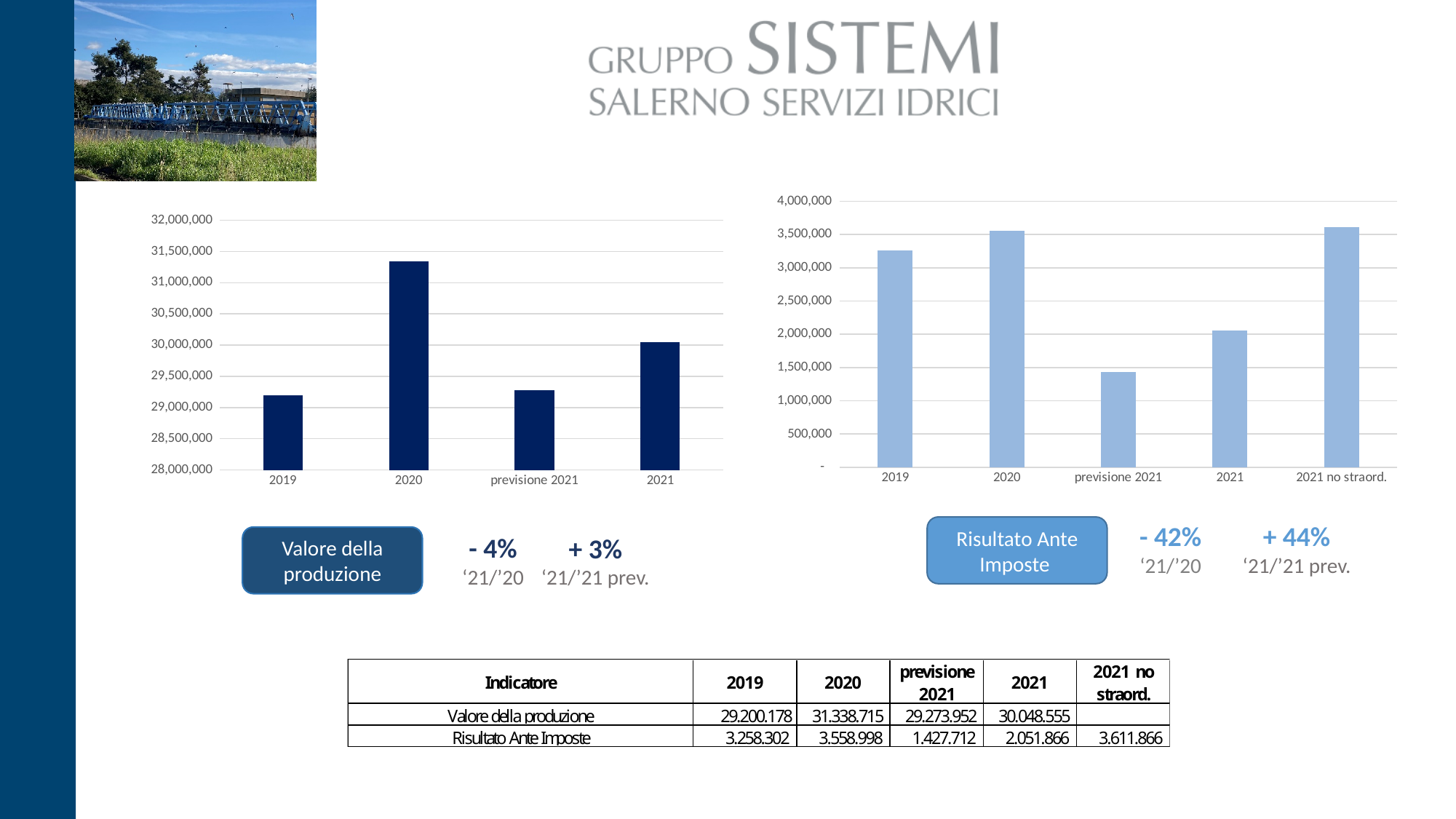
In the left chart (Valore della produzione), is the value for 2020 greater or less than 31,000,000? greater In the right chart (Risultato Ante Imposte), which is larger, the value for 2019 or the value for 2021? 2019 According to the table, what is the Valore della produzione for 2020? 31.338.715 How many categories are shown on the x axis of the left chart (Valore della produzione)? 4 How many categories are shown on the x axis of the right chart (Risultato Ante Imposte)? 5 What kind of chart is the left chart (Valore della produzione)? bar chart According to the table, what is the difference between the Risultato Ante Imposte for 2020 and for 2019? 300.696 What percentage change '21/'20 is shown next to the Valore della produzione chart? - 4% In the right chart (Risultato Ante Imposte), is the value for previsione 2021 greater or less than 1,500,000? less In the left chart (Valore della produzione), which year has the highest bar? 2020 In the right chart (Risultato Ante Imposte), which category has the lowest bar? previsione 2021 In the left chart (Valore della produzione), is the value for 2019 greater or less than 29,500,000? less